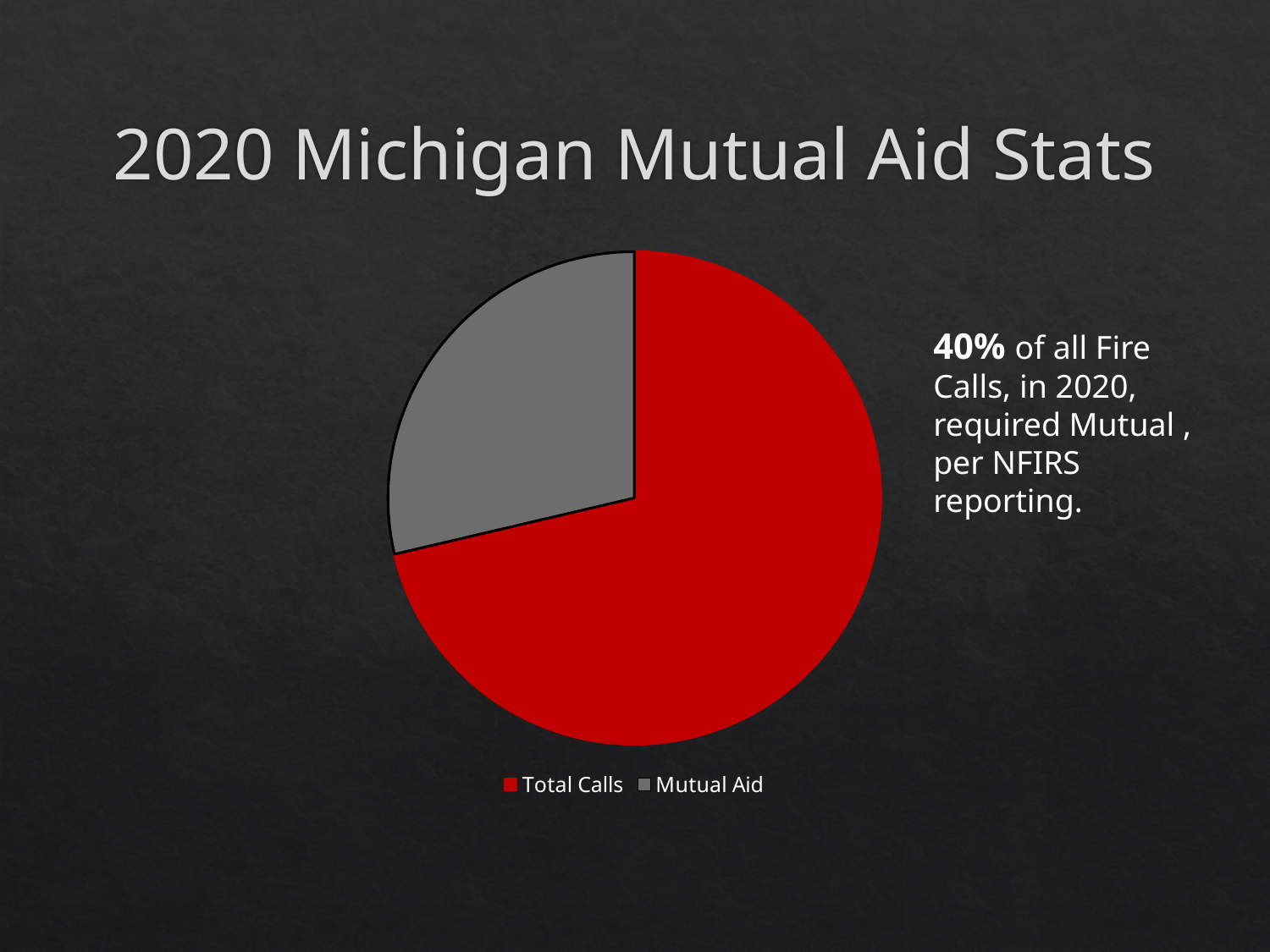
What colour is the Mutual Aid slice in the pie chart? gray What colour is the Total Calls slice in the pie chart? red How many entries does the legend of the pie chart list? 2 Which slice of the pie chart is the largest? Total Calls How many slices does the pie chart have? 2 What kind of chart is shown on the slide? pie chart Which slice is larger in the pie chart, Total Calls or Mutual Aid? Total Calls Which slice of the pie chart is the smallest? Mutual Aid